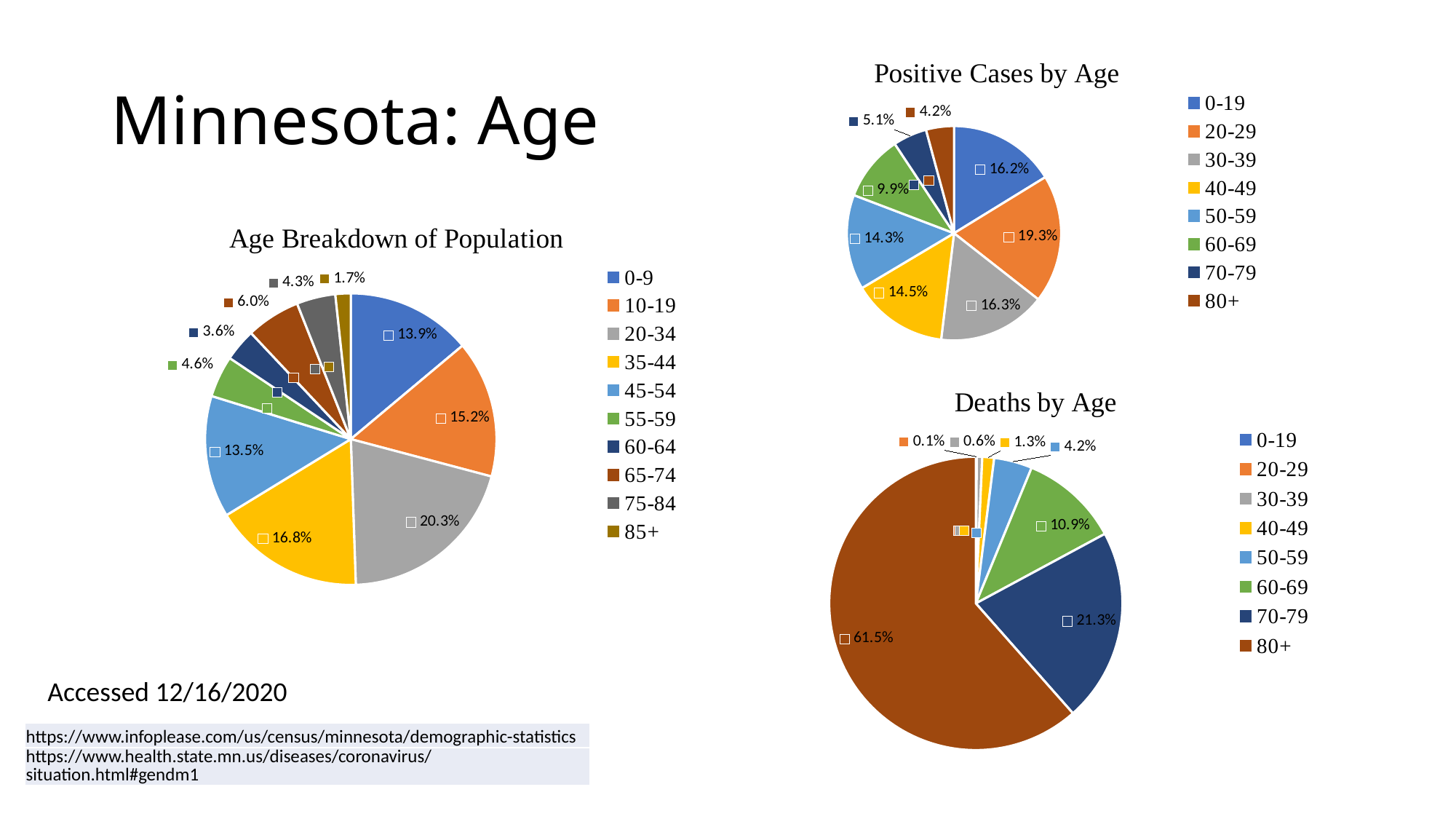
In the Positive Cases by Age chart, which age group has the largest share of cases? 20-29 In the Deaths by Age chart, what percentage of deaths are in the 80+ age group? 61.5% In the Age Breakdown of Population chart, what share of the population is aged 20-34? 20.3% In the Positive Cases by Age chart, what percentage of positive cases are in the 20-29 age group? 19.3% In the Age Breakdown of Population chart, which age group has the largest share? 20-34 In the Age Breakdown of Population chart, which age group has the smallest share? 85+ In the Positive Cases by Age chart, what is the difference between the shares for 60-69 and 70-79? 4.8% In the Age Breakdown of Population chart, how many age groups does the legend list? 10 In the Deaths by Age chart, what is the combined share of the 70-79 and 80+ age groups? 82.8% In the Deaths by Age chart, which age group has the largest share of deaths? 80+ In the Deaths by Age chart, which is larger: the share for 60-69 or the share for 70-79? 70-79 What type of chart is used for Deaths by Age? Pie chart